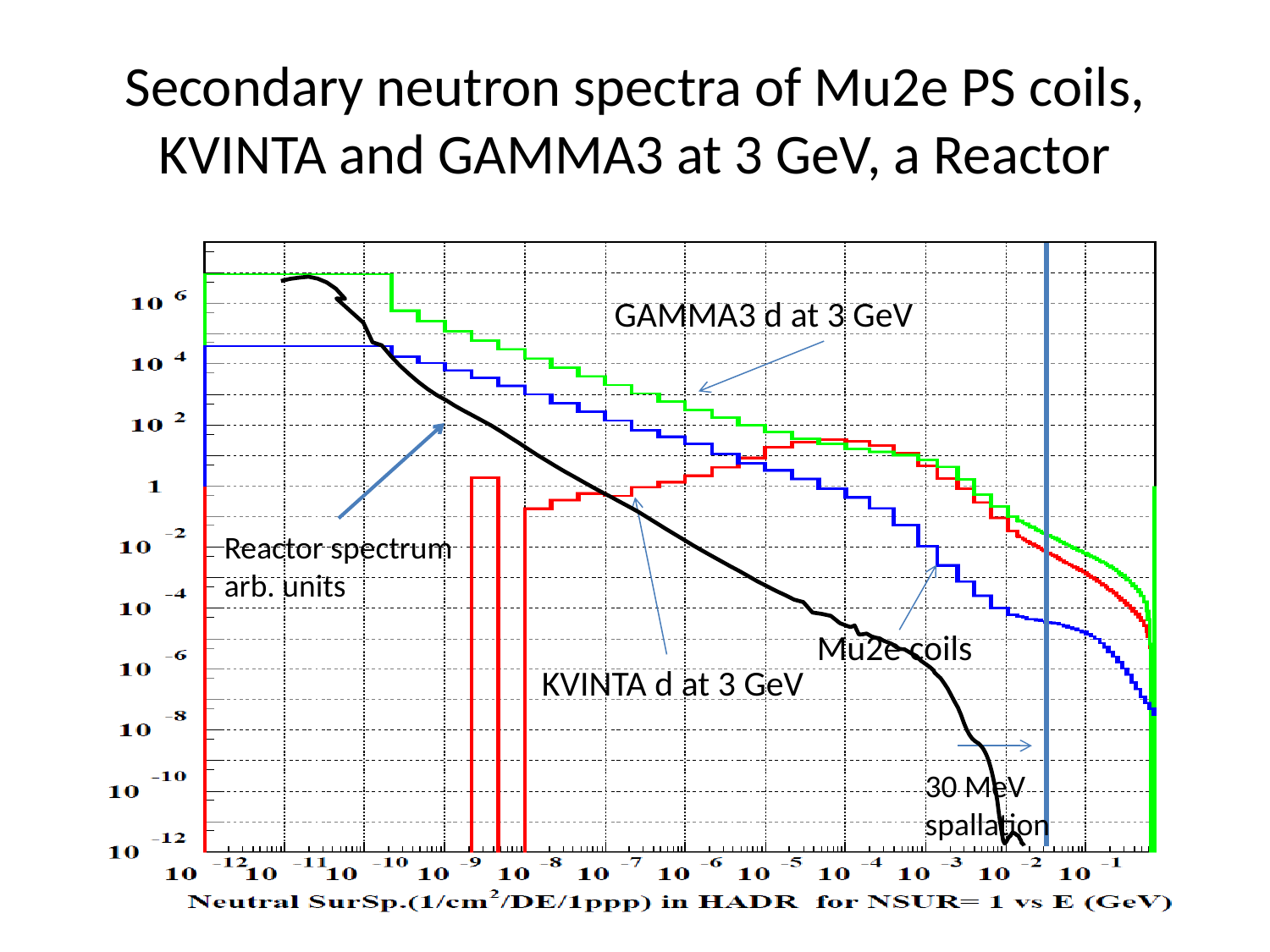
At 10^-1 GeV, is the Mu2e coils value greater or less than 10^-4? less Does the Reactor spectrum curve rise or fall as energy increases along the x axis? fall Which curve is highest at an energy of 10^-6 GeV? GAMMA3 d at 3 GeV How many labelled spectra (curves) are plotted on the chart? 4 At 10^-5 GeV, which is larger: the GAMMA3 d at 3 GeV curve or the Reactor spectrum curve? GAMMA3 d at 3 GeV Which curve is lowest at an energy of 10^-3 GeV? Reactor spectrum What energy does the vertical line near 3×10^-2 GeV mark, according to the annotation? 30 MeV spallation What kind of chart is shown on the slide? line chart At 10^-10 GeV, is the GAMMA3 d at 3 GeV value greater or less than 10^4? greater At 10^-3 GeV, is the Reactor spectrum value greater or less than 10^-4? less What is the title of the slide? Secondary neutron spectra of Mu2e PS coils, KVINTA and GAMMA3 at 3 GeV, a Reactor